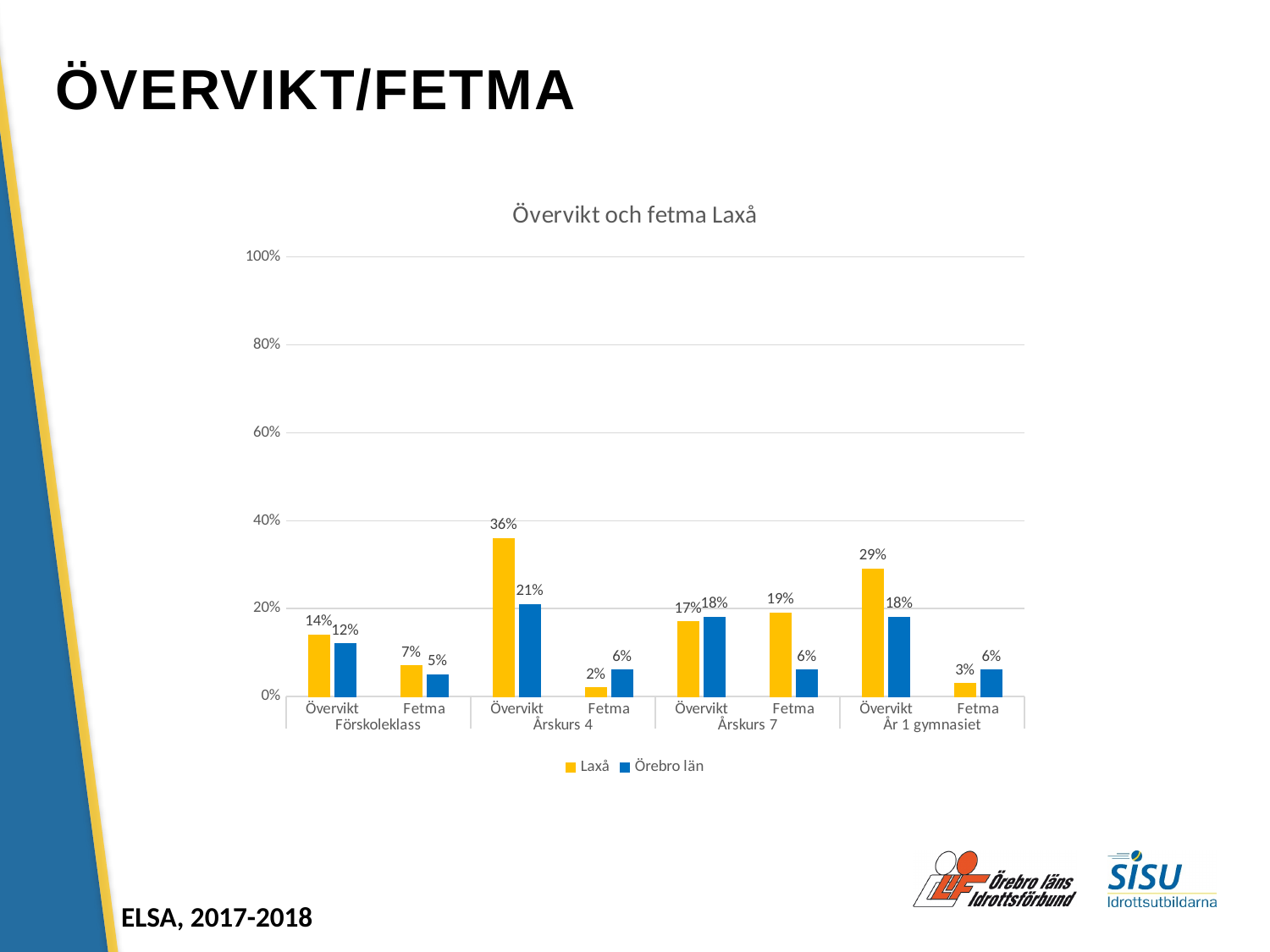
How many series does the legend list? 2 Which category has the lowest Laxå value? Fetma, Årskurs 4 What is the difference between the Laxå and Örebro län values for Övervikt in Årskurs 4? 15% What is the value for Örebro län for Fetma in Förskoleklass? 5% Is the Laxå value for Övervikt in Årskurs 4 greater or less than 20%? greater What is the title of the chart? Övervikt och fetma Laxå What is the value for Laxå for Övervikt in Årskurs 4? 36% Which category has the highest Laxå value? Övervikt, Årskurs 4 What kind of chart is shown? Bar chart Which is larger for Fetma in Årskurs 7: Laxå or Örebro län? Laxå What is the value for Laxå for Övervikt in År 1 gymnasiet? 29% What is the value for Örebro län for Övervikt in Årskurs 7? 18%